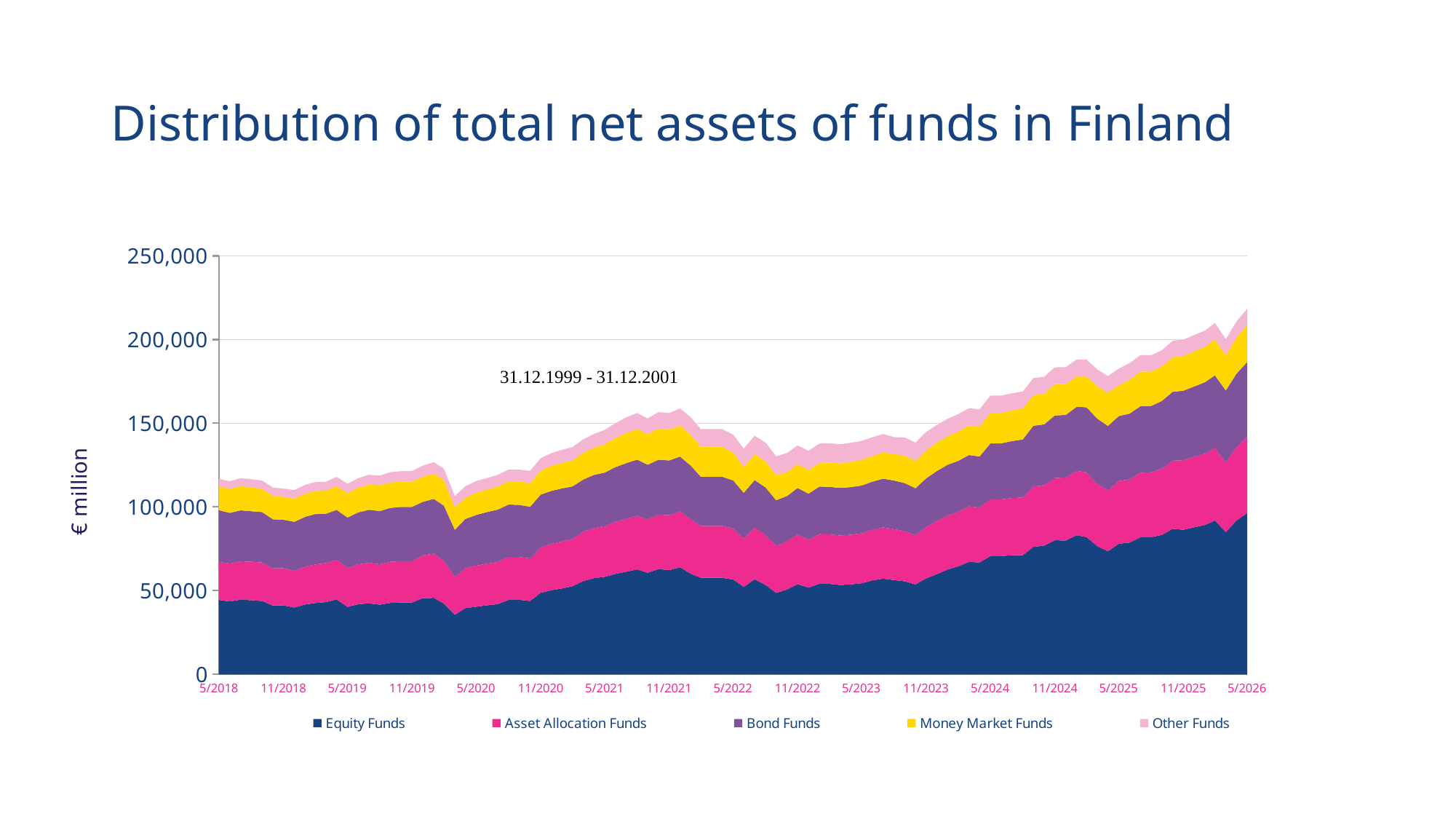
Is the Equity Funds value at 5/2026 greater or less than 50,000? greater How many series does the legend list? 5 Is the total net assets value at 5/2018 greater or less than 150,000? less What unit is shown on the vertical axis label? € million Which series has the largest value at 5/2026? Equity Funds Overall, do total net assets rise or fall from 5/2018 to 5/2026? rise How many date labels are shown on the x axis? 17 Is the total net assets value at 5/2020 greater or less than 150,000? less Which series has the smallest value at 5/2026? Other Funds What kind of chart is shown on the slide? Stacked area chart What is the title of the chart? Distribution of total net assets of funds in Finland